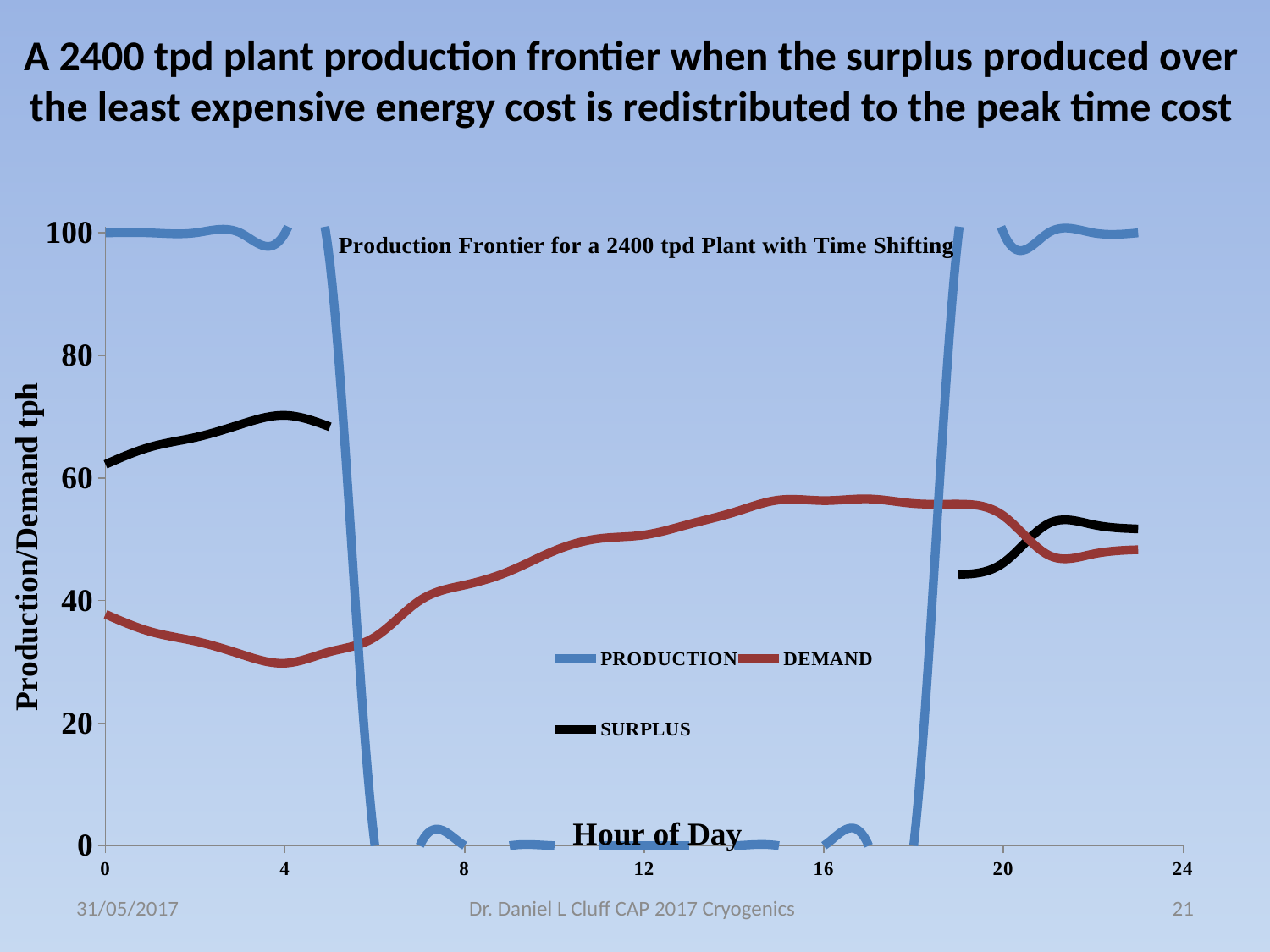
How many series does the chart legend list? 3 Is the DEMAND value at hour 16 greater or less than 40? greater Is the DEMAND value at hour 4 greater or less than 40? less Is the SURPLUS value at hour 4 greater or less than 60? greater What is the label of the vertical axis of the chart? Production/Demand tph What is the title of the chart? Production Frontier for a 2400 tpd Plant with Time Shifting What kind of chart is shown on the slide? line chart Does the DEMAND series rise or fall between hour 4 and hour 16? rise Which series has the highest value at hour 0? PRODUCTION What is the PRODUCTION value at hour 0? 100 What is the PRODUCTION value at hour 12? 0